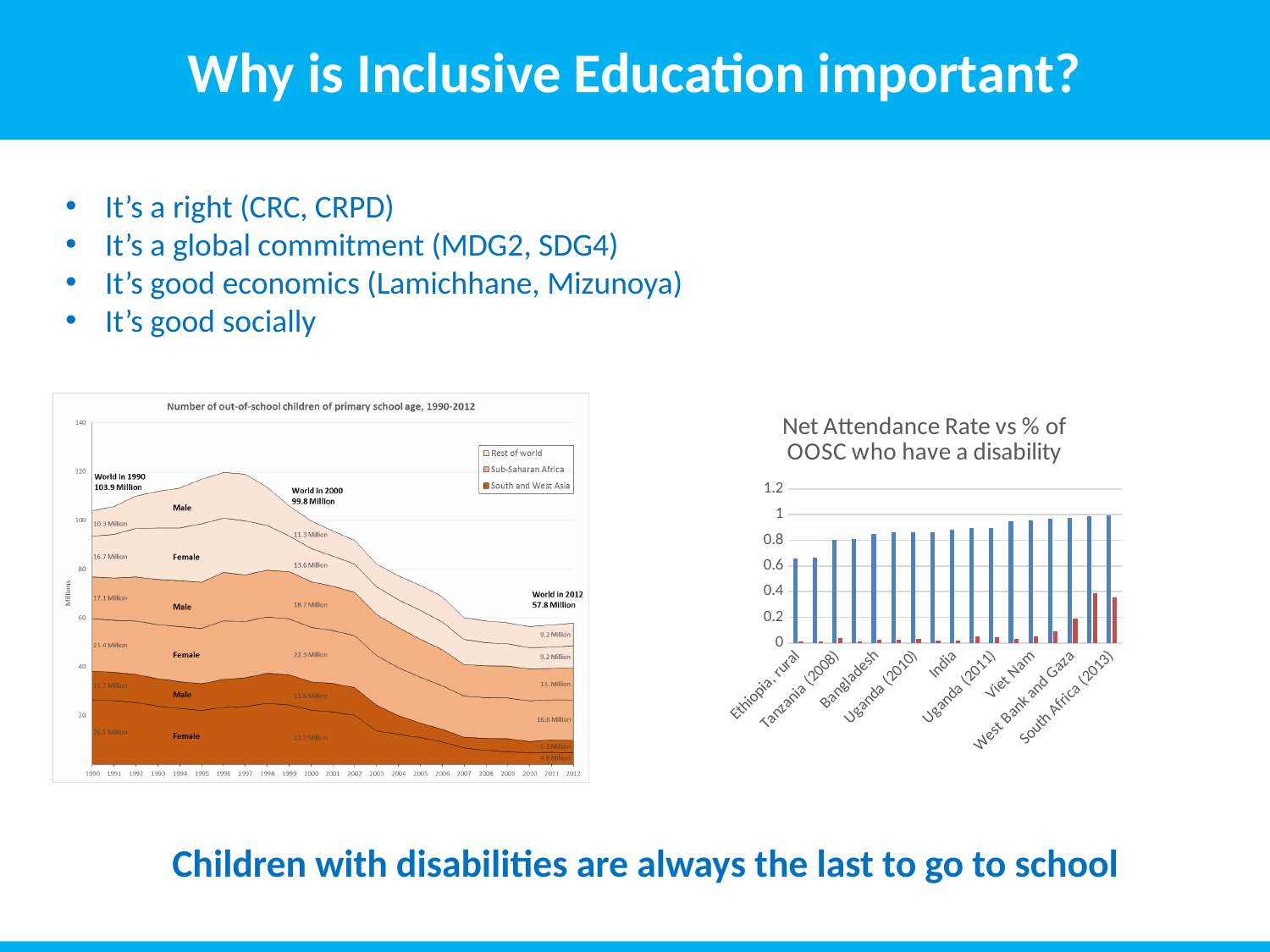
What kind of chart is the right chart, 'Net Attendance Rate vs % of OOSC who have a disability'? Bar chart In the left chart, what was the world total of out-of-school children in 2012? 57.8 Million In the left chart, by how much did the world total of out-of-school children fall between 1990 and 2012? 46.1 Million How many series does the legend of the left chart list? 3 In the left chart, what was the world total of out-of-school children in 2000? 99.8 Million In the left chart, is the world total in 1990 larger or smaller than the world total in 2012? Larger In the right chart, is the blue bar for Ethiopia, rural greater or less than 0.8? less In the left chart, what was the world total of out-of-school children in 1990? 103.9 Million What is the title of the right chart? Net Attendance Rate vs % of OOSC who have a disability In the left chart, does the total number of out-of-school children rise or fall overall from 1990 to 2012? Fall In the right chart, do the blue bars generally rise or fall from left to right along the x axis? Rise What kind of chart is the left chart, 'Number of out-of-school children of primary school age, 1990-2012'? Area chart